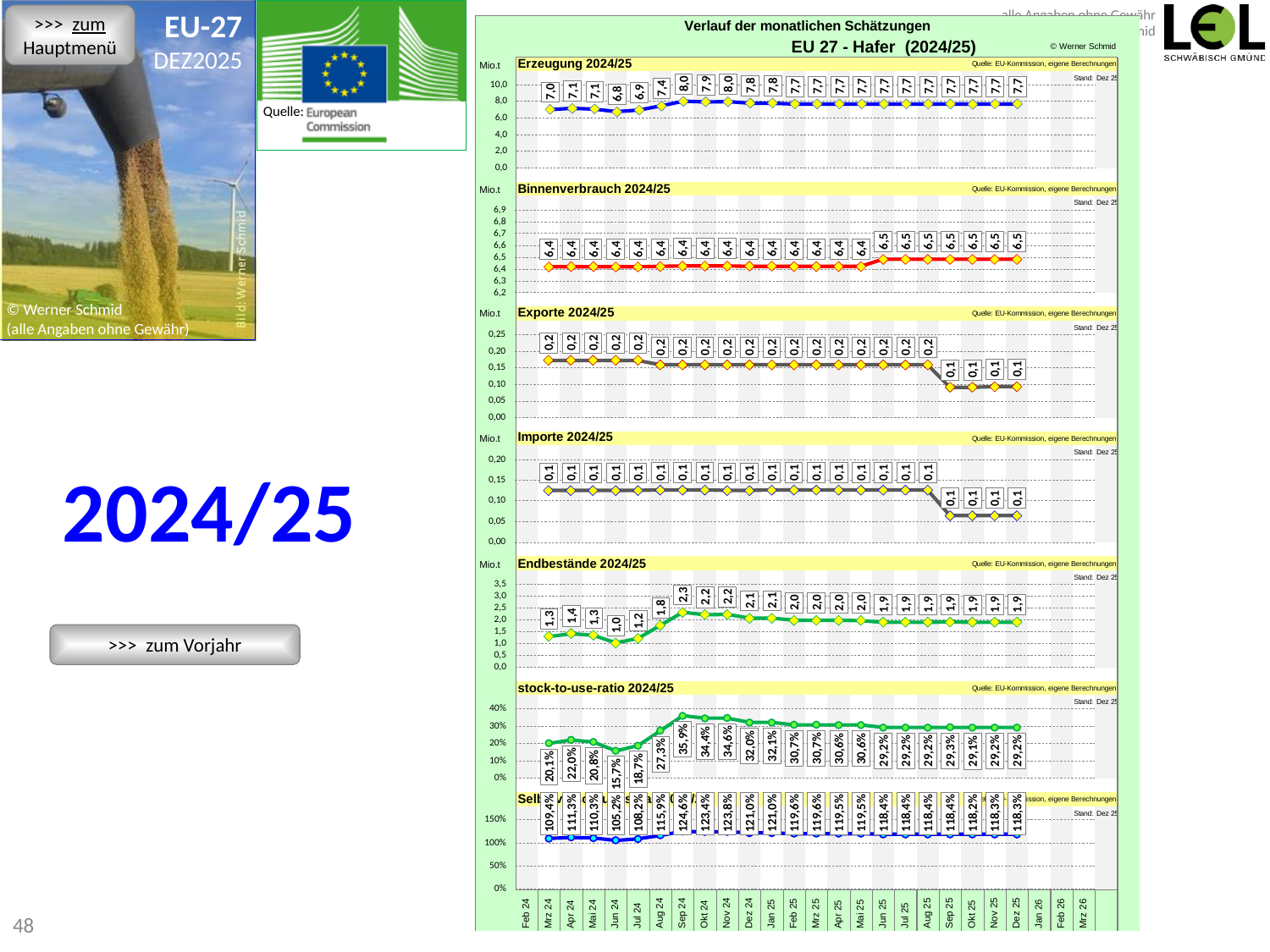
In the 'stock-to-use-ratio 2024/25' chart, is the value for Jun 24 greater or less than 20%? less In the 'Binnenverbrauch 2024/25' chart, what is the value for Dez 25? 6,5 In the 'Erzeugung 2024/25' chart, what is the difference between the values for Sep 24 and Jun 24? 1,2 What type of chart is the 'Importe 2024/25' chart? line chart In the 'stock-to-use-ratio 2024/25' chart, what is the value for Sep 24? 35,9% In the 'Exporte 2024/25' chart, what is the value for Nov 25? 0,1 In the 'Erzeugung 2024/25' chart, which month has the lowest value? Jun 24 In the 'Erzeugung 2024/25' chart, what is the value for Sep 24? 8,0 In the 'Endbestände 2024/25' chart, what is the value for Jun 24? 1,0 In the 'Endbestände 2024/25' chart, which month has the highest value? Sep 24 In the bottom chart of the slide (the one with values above 100%), what is the value for Sep 24? 124,6% In the 'stock-to-use-ratio 2024/25' chart, which is larger, the value for Apr 24 or the value for Jul 24? Apr 24